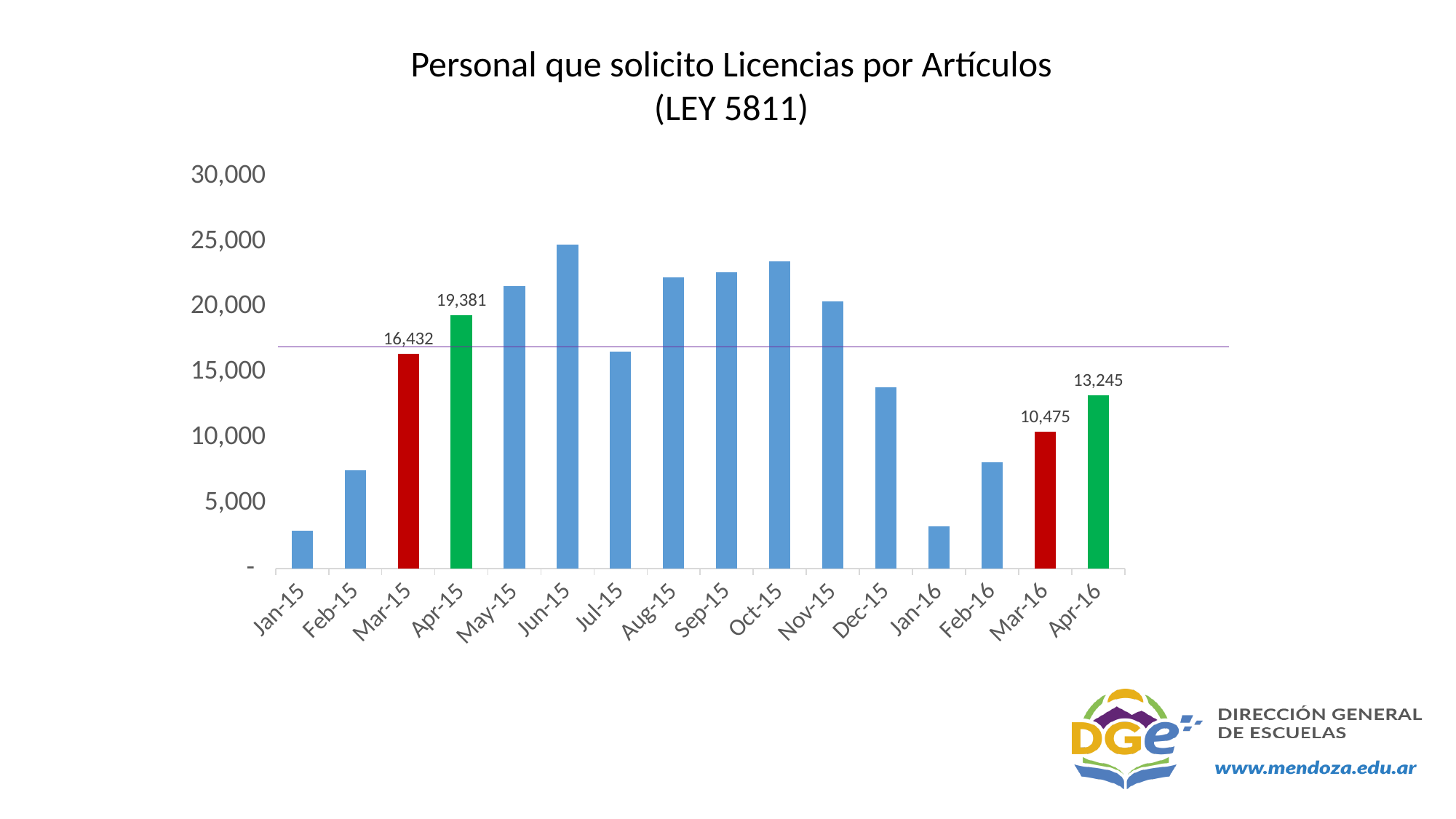
What is the value for Apr-16? 13,245 Which month has the lowest bar? Jan-15 Is the value for Jun-15 greater or less than 20,000? greater Which month has the highest bar? Jun-15 What is the value for Mar-16? 10,475 What type of chart is shown on the slide? bar chart What is the difference between the values for Apr-15 and Mar-15? 2,949 What is the difference between the values for Apr-16 and Mar-16? 2,770 How many months are shown on the x axis? 16 What is the value for Mar-15? 16,432 What is the value for Apr-15? 19,381 Which is larger, the value for Mar-15 or the value for Mar-16? Mar-15